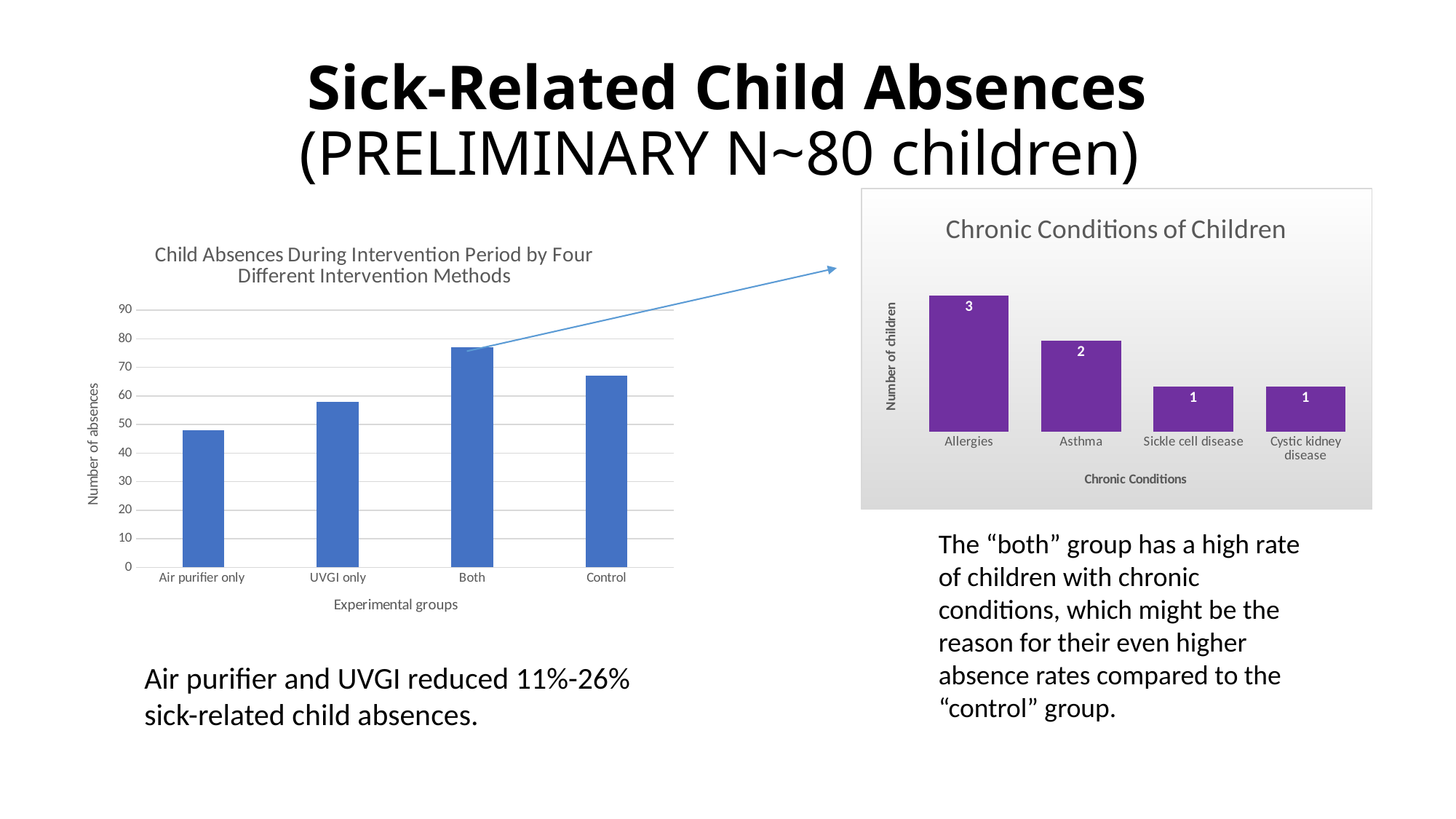
In the 'Chronic Conditions of Children' chart, how many children have asthma? 2 In the 'Child Absences During Intervention Period' chart, which experimental group has the highest number of absences? Both In the 'Child Absences During Intervention Period' chart, which has more absences, 'UVGI only' or 'Control'? Control In the 'Chronic Conditions of Children' chart, what is the difference between the number of children with allergies and the number with asthma? 1 In the 'Child Absences During Intervention Period' chart, is the number of absences for 'Air purifier only' greater or less than 50? less In the 'Child Absences During Intervention Period' chart, which experimental group has the lowest number of absences? Air purifier only In the 'Child Absences During Intervention Period' chart, is the number of absences for 'Both' greater or less than 70? greater In the 'Chronic Conditions of Children' chart, how many chronic conditions are shown? 4 In the 'Chronic Conditions of Children' chart, which chronic condition has the highest number of children? Allergies In the 'Child Absences During Intervention Period' chart, how many experimental groups are shown? 4 In the 'Chronic Conditions of Children' chart, how many children have allergies? 3 What type of chart is the 'Chronic Conditions of Children' chart? Bar chart